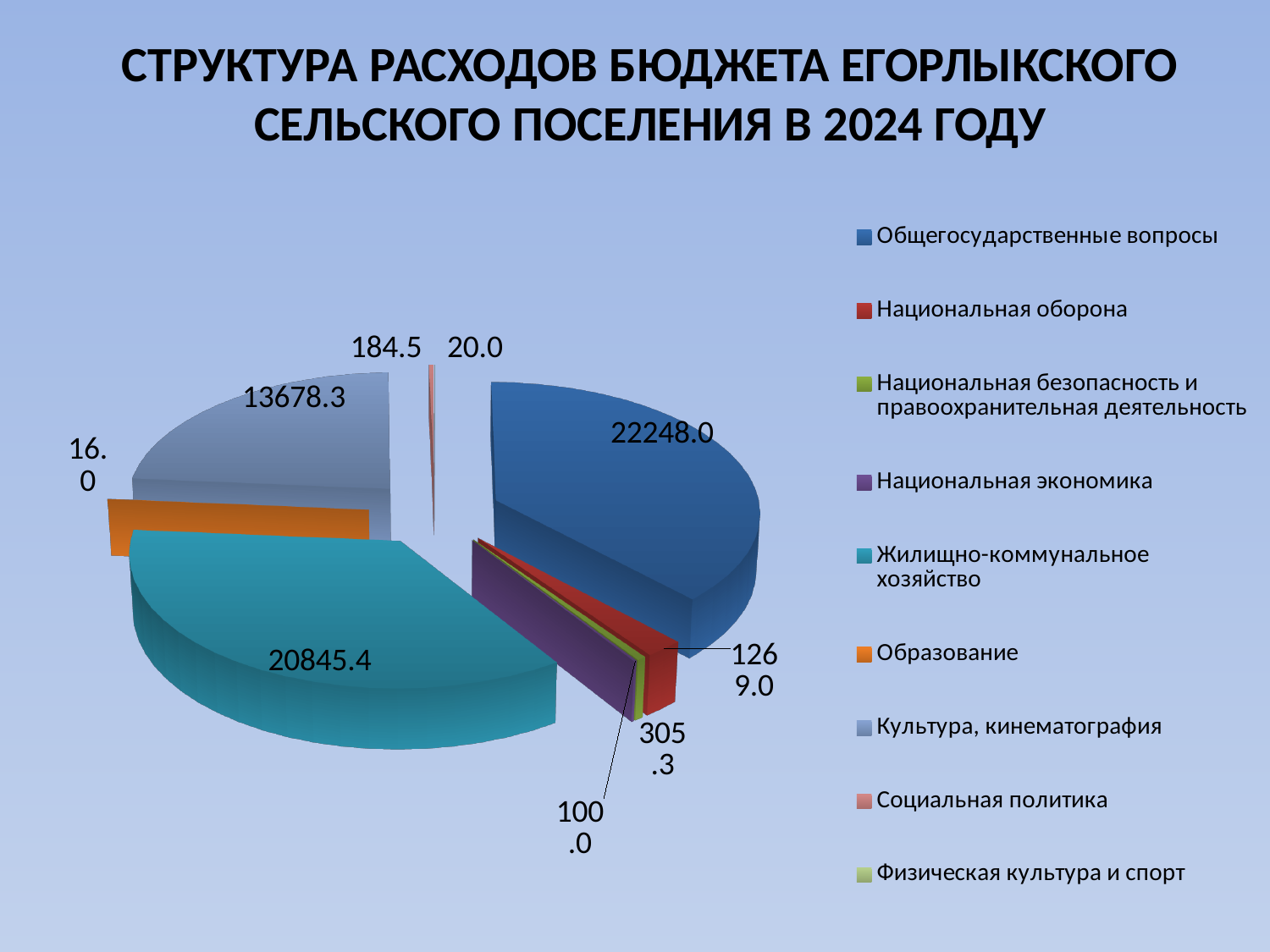
What is the difference between the values for Общегосударственные вопросы and Жилищно-коммунальное хозяйство? 1402.6 What is the value shown for Образование? 16.0 What is the value shown for Культура, кинематография? 13678.3 What is the value shown for Социальная политика? 184.5 What is the value shown for Общегосударственные вопросы? 22248.0 How many categories does the legend of the pie chart list? 9 What kind of chart is shown on the slide? Pie chart What year does the chart title say the budget expenditure structure refers to? 2024 Which category has the smallest value in the pie chart? Образование Which is larger: Жилищно-коммунальное хозяйство or Культура, кинематография? Жилищно-коммунальное хозяйство What is the value shown for Жилищно-коммунальное хозяйство? 20845.4 Which category has the largest slice of the pie? Общегосударственные вопросы